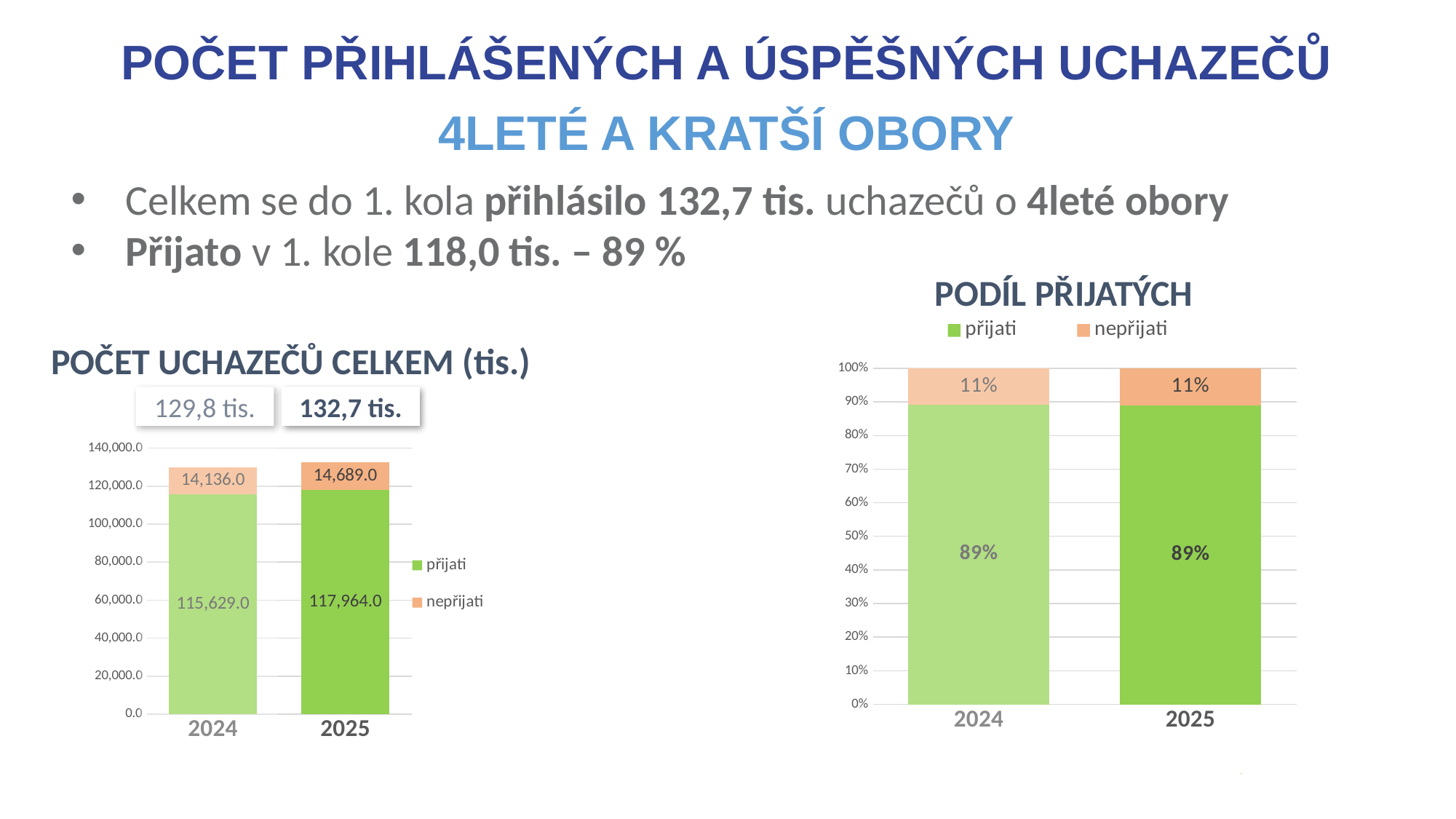
What kind of chart is the chart titled PODÍL PŘIJATÝCH? stacked bar chart In the chart titled POČET UCHAZEČŮ CELKEM (tis.), is the total for 2024 greater or less than 120,000.0? greater In the chart titled POČET UCHAZEČŮ CELKEM (tis.), what is the difference between the přijati values for 2025 and 2024? 2,335.0 In the chart titled POČET UCHAZEČŮ CELKEM (tis.), what is the value for přijati in 2024? 115,629.0 In the chart titled POČET UCHAZEČŮ CELKEM (tis.), what total is shown above the 2025 bar? 132,7 tis. In the chart titled PODÍL PŘIJATÝCH, how many years are shown on the x axis? 2 In the chart titled POČET UCHAZEČŮ CELKEM (tis.), how many series does the legend list? 2 In the chart titled PODÍL PŘIJATÝCH, what is the share of přijati in 2024? 89% In the chart titled POČET UCHAZEČŮ CELKEM (tis.), what is the value for nepřijati in 2024? 14,136.0 In the chart titled PODÍL PŘIJATÝCH, what is the share of nepřijati in 2025? 11% In the chart titled POČET UCHAZEČŮ CELKEM (tis.), which year has the larger nepřijati value, 2024 or 2025? 2025 In the chart titled POČET UCHAZEČŮ CELKEM (tis.), what is the value for přijati in 2025? 117,964.0